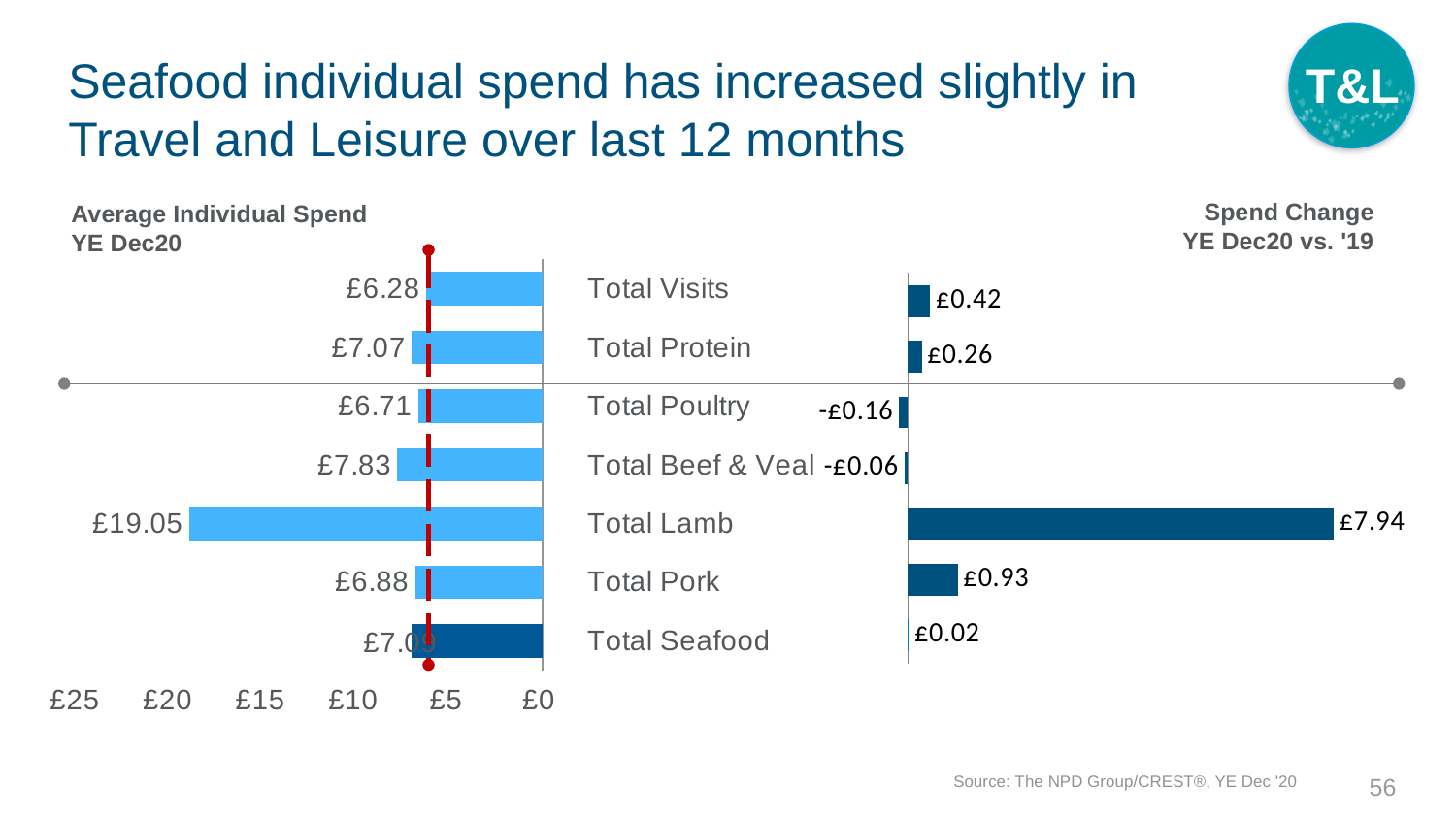
In the Spend Change YE Dec20 vs. '19 chart, which category has the lowest spend change? Total Poultry What kind of chart is the Spend Change YE Dec20 vs. '19 chart? Bar chart In the Average Individual Spend YE Dec20 chart, which category has the highest spend? Total Lamb In the Average Individual Spend YE Dec20 chart, what is the difference between the values for Total Beef & Veal and Total Protein? £0.76 In the Average Individual Spend YE Dec20 chart, what is the value for Total Lamb? £19.05 In the Spend Change YE Dec20 vs. '19 chart, what is the value for Total Pork? £0.93 How many categories are shown in the Average Individual Spend YE Dec20 chart? 7 In the Spend Change YE Dec20 vs. '19 chart, which category has the largest spend change? Total Lamb In the Spend Change YE Dec20 vs. '19 chart, what is the difference between the values for Total Lamb and Total Pork? £7.01 In the Average Individual Spend YE Dec20 chart, which is larger: Total Beef & Veal or Total Poultry? Total Beef & Veal In the Average Individual Spend YE Dec20 chart, which category has the lowest spend? Total Visits In the Spend Change YE Dec20 vs. '19 chart, what is the value for Total Seafood? £0.02